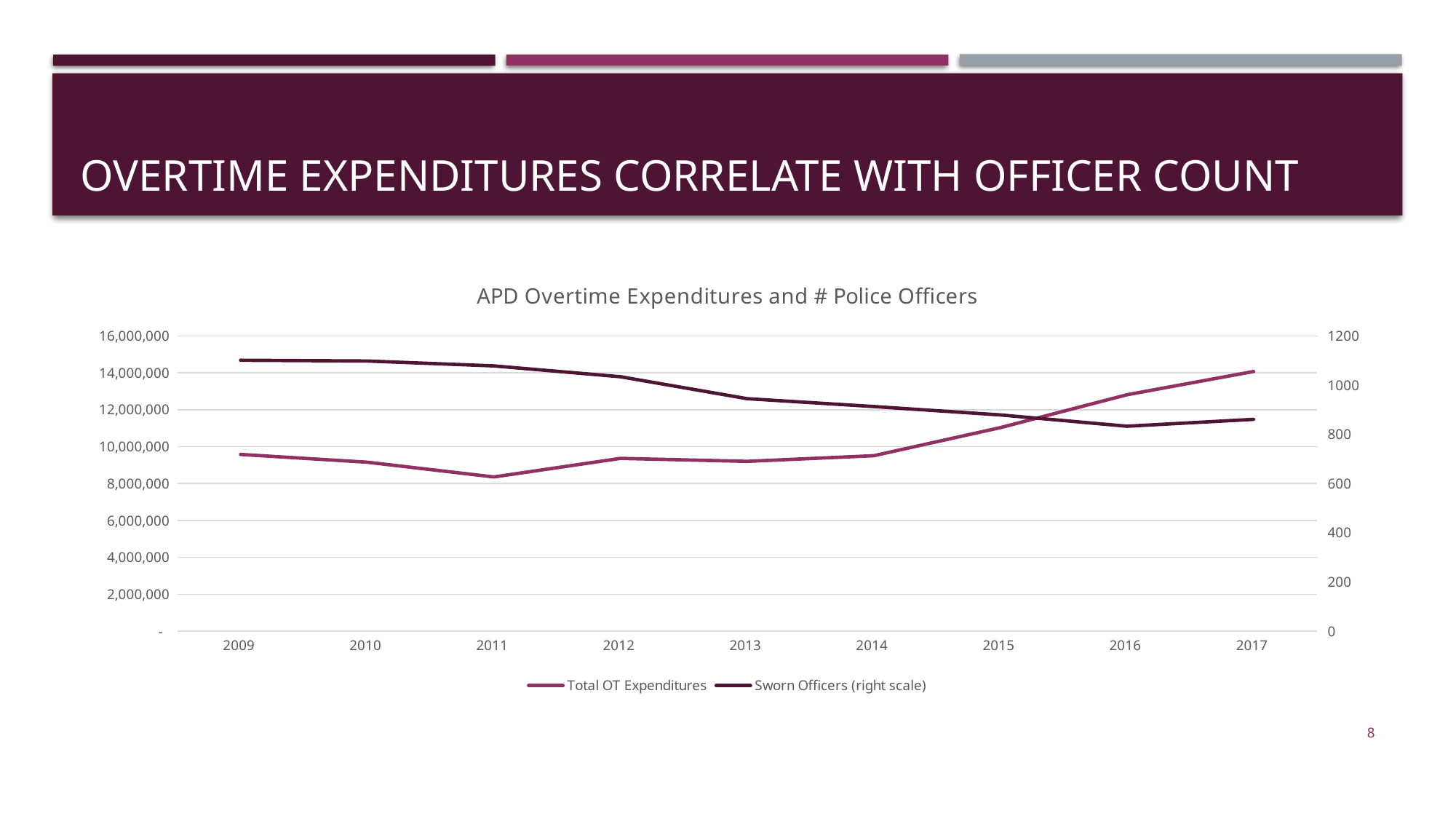
What is the title of the chart? APD Overtime Expenditures and # Police Officers In which year is Total OT Expenditures lowest? 2011 How many series does the legend list? 2 Is the Sworn Officers value for 2016 greater or less than 1000? less What kind of chart is shown on the slide? Line chart Is the Total OT Expenditures value for 2017 greater or less than 12,000,000? greater Is the Total OT Expenditures value for 2011 greater or less than 10,000,000? less Does the Sworn Officers series generally rise or fall from 2009 to 2017? Fall In which year is Total OT Expenditures highest? 2017 How many years are plotted along the x axis? 9 Which is larger: Total OT Expenditures in 2009 or in 2017? 2017